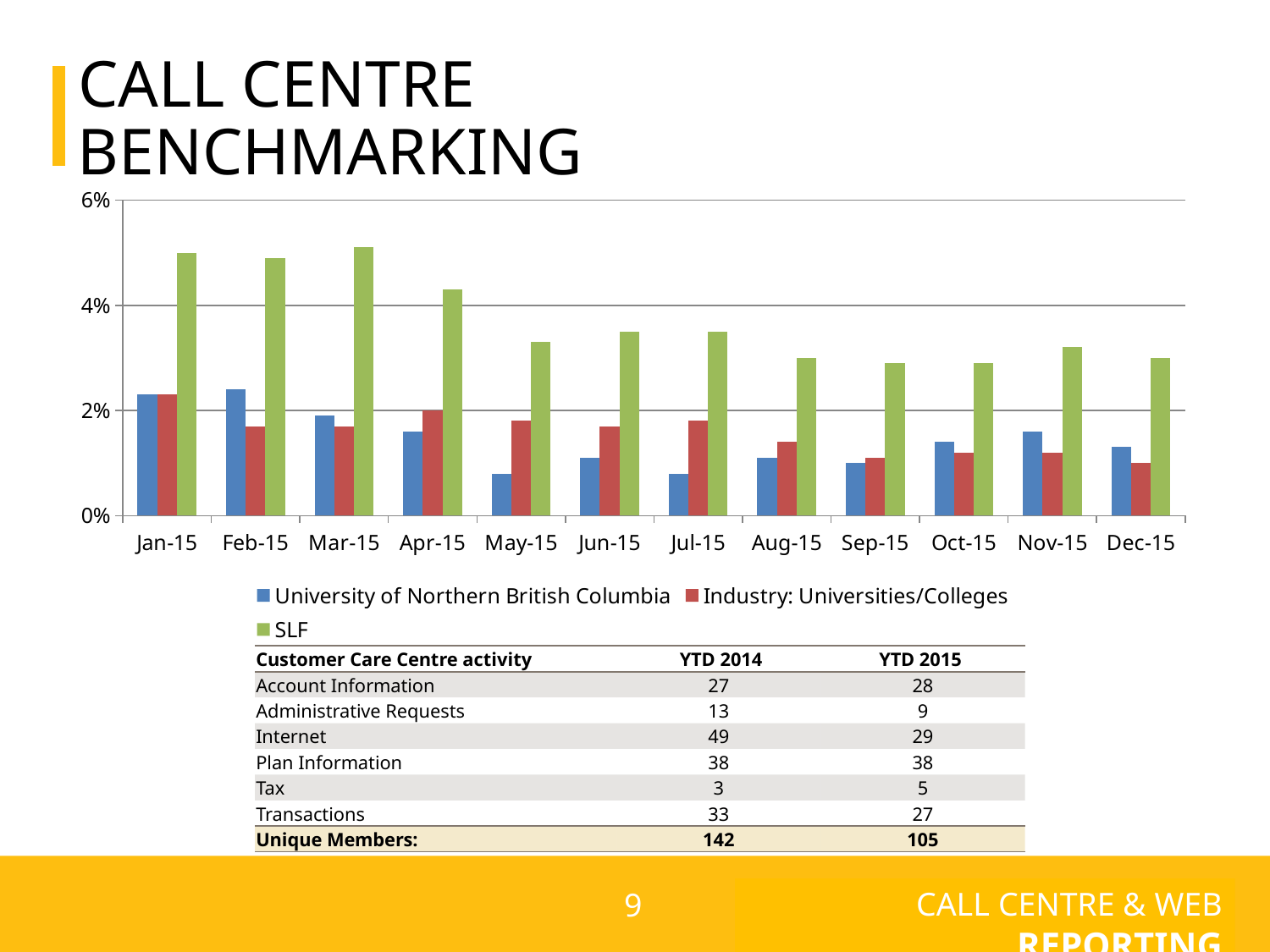
Is the Industry: Universities/Colleges value for Feb-15 greater or less than 2%? less Is the SLF value for Jan-15 greater or less than 4%? greater In May-15, which is larger: the University of Northern British Columbia value or the Industry: Universities/Colleges value? Industry: Universities/Colleges Do the SLF values generally rise or fall from Jan-15 to Dec-15? Fall In Jan-15, which is larger: the SLF value or the University of Northern British Columbia value? SLF How many series does the chart legend list? 3 What colour are the SLF bars in the chart? Green Is the SLF value for Dec-15 greater or less than 4%? less What kind of chart is shown on the slide? Bar chart How many months are shown along the x axis of the chart? 12 Which series has the highest value in every month shown? SLF